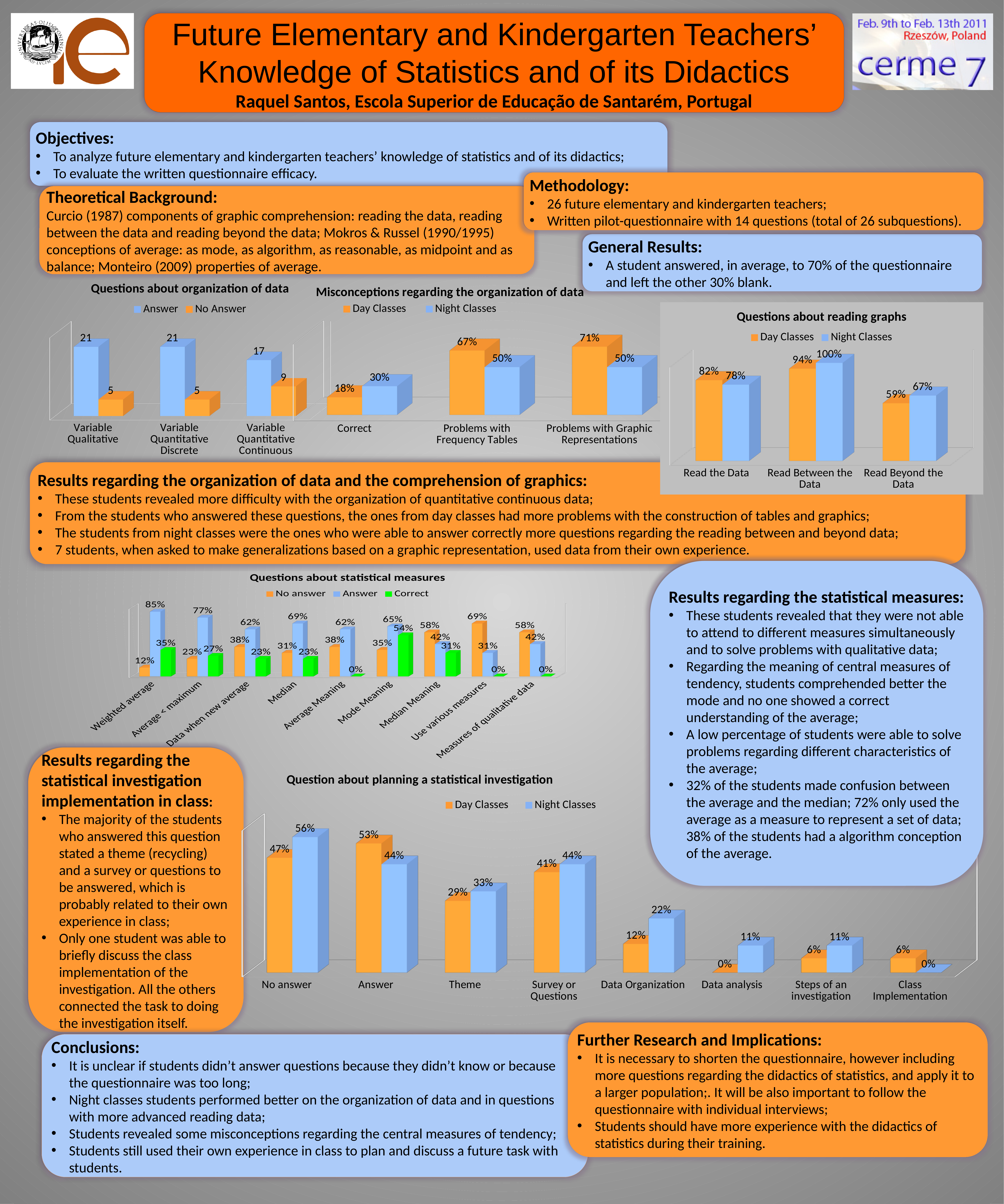
In the 'Misconceptions regarding the organization of data' chart, what is the Day Classes value for Problems with Graphic Representations? 71% In the 'Questions about statistical measures' chart, what is the Correct value for Mode Meaning? 54% In the 'Questions about reading graphs' chart, what is the Night Classes value for Read Between the Data? 100% In the 'Questions about organization of data' chart, which category has the highest No Answer value? Variable Quantitative Continuous In the 'Questions about statistical measures' chart, how many series does the legend list? 3 In the 'Question about planning a statistical investigation' chart, what is the Night Classes value for Data Organization? 22% In the 'Misconceptions regarding the organization of data' chart, what is the difference between Day Classes and Night Classes for Problems with Frequency Tables? 17% In the 'Questions about statistical measures' chart, which category has the highest Answer value? Weighted average What kind of chart is 'Question about planning a statistical investigation'? Bar chart In the 'Questions about reading graphs' chart, which is larger for Read Beyond the Data: Day Classes or Night Classes? Night Classes In the 'Question about planning a statistical investigation' chart, how many categories are shown on the x axis? 8 In the 'Questions about organization of data' chart, what is the Answer value for Variable Quantitative Continuous? 17